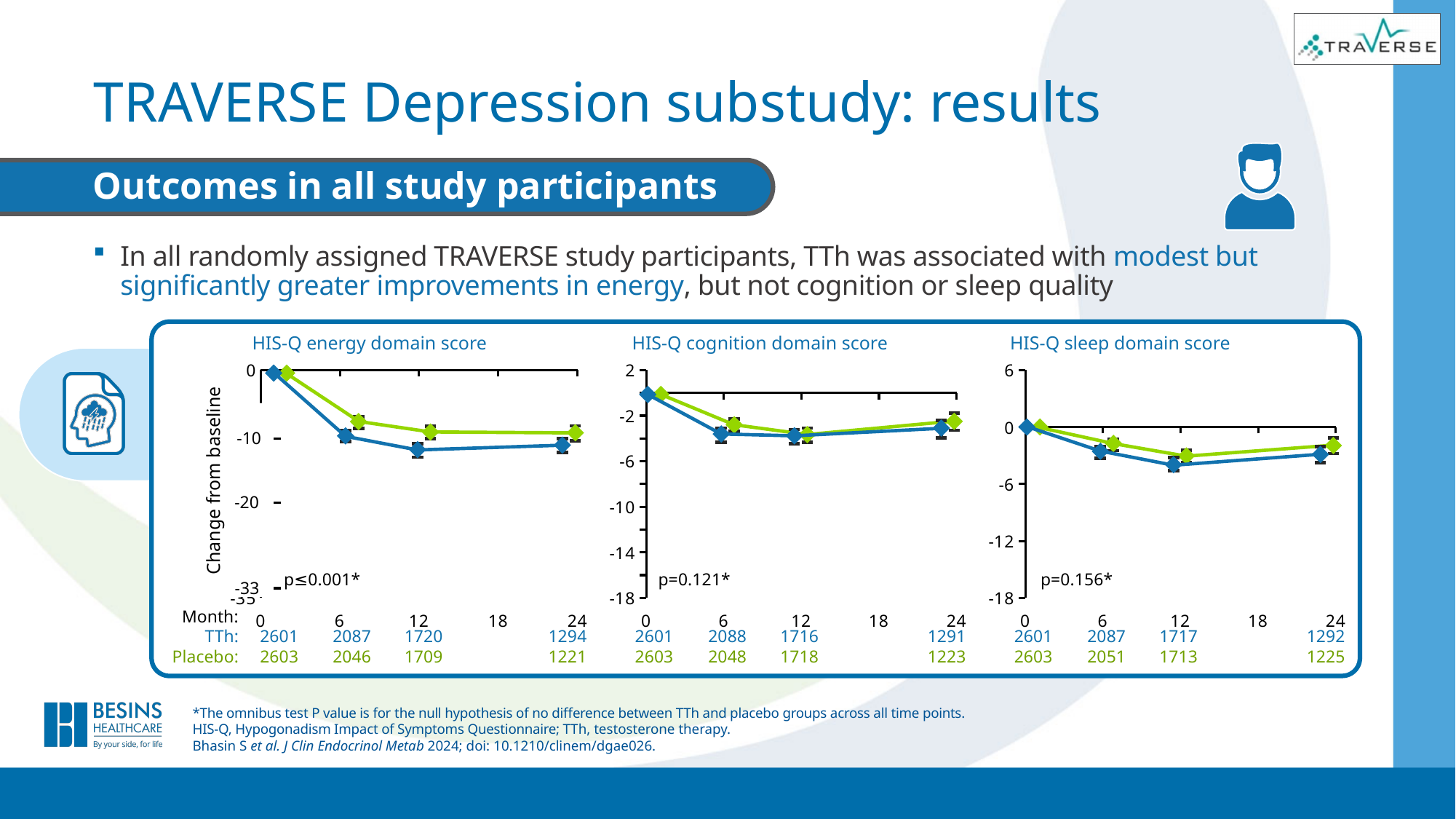
In the HIS-Q energy domain score chart, how many TTh participants are listed at month 0? 2601 In the HIS-Q sleep domain score chart, is the TTh value at month 12 greater or less than -6? greater What kind of chart is used for the HIS-Q energy domain score? line chart In the HIS-Q cognition domain score chart, which group has more participants listed at month 24, TTh or placebo? TTh In the HIS-Q sleep domain score chart, what p-value is printed? p=0.156* In the HIS-Q energy domain score chart, what p-value is printed? p≤0.001* In the HIS-Q cognition domain score chart, what p-value is printed? p=0.121* How many charts are shown in the panel on the slide? 3 In the HIS-Q energy domain score chart, what is the difference between the TTh and placebo participant counts at month 6? 41 In the HIS-Q energy domain score chart, is the placebo value at month 6 greater or less than -10? greater In the HIS-Q sleep domain score chart, how many placebo participants are listed at month 24? 1225 In the HIS-Q energy domain score chart, do the TTh values rise or fall from month 0 to month 12? fall